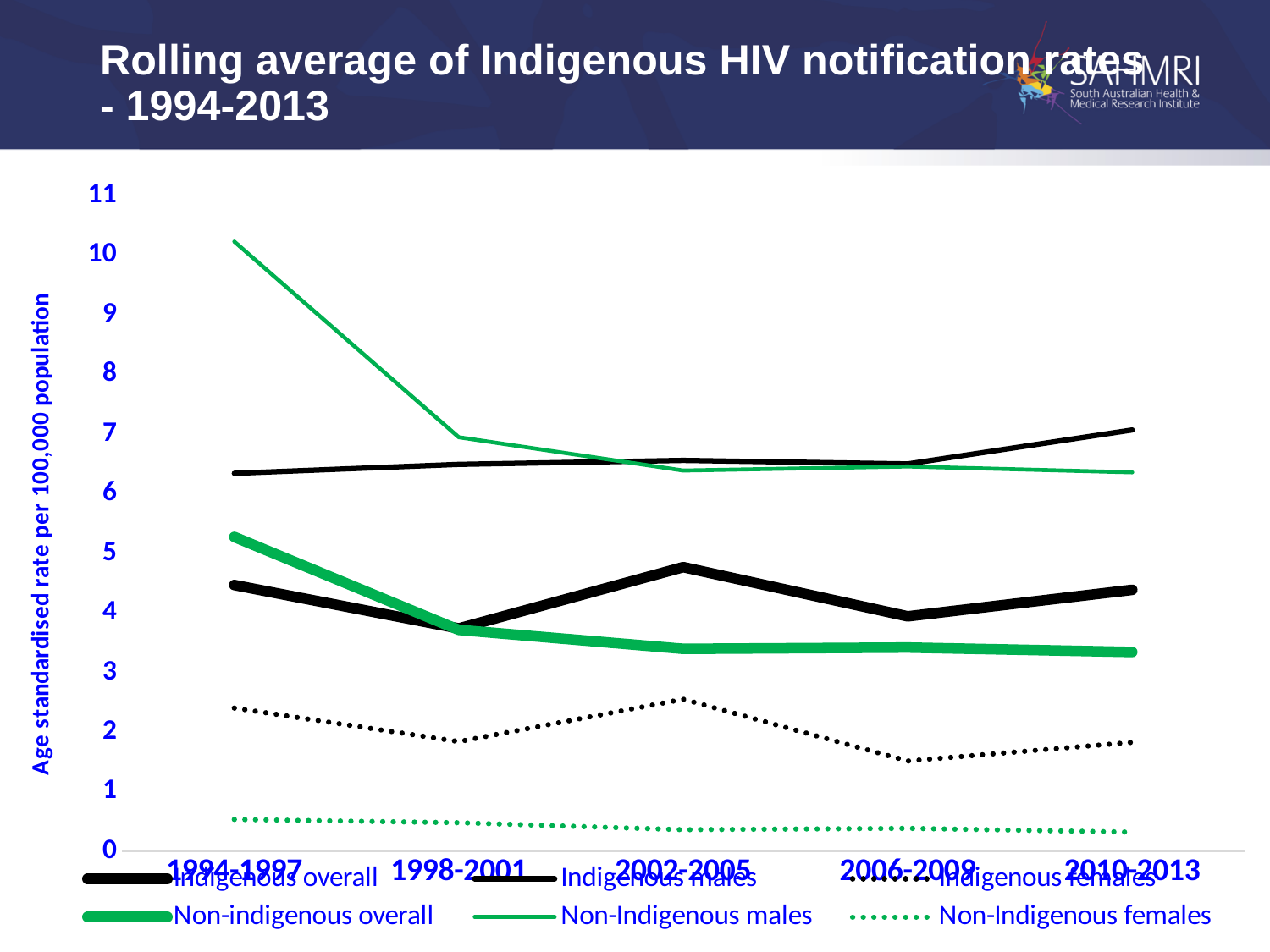
What kind of chart is shown on the slide? Line chart What is the label of the y axis? Age standardised rate per 100,000 population Is the value for Non-indigenous overall in 2010-2013 greater or less than 4? less Is the value for Indigenous males in 2010-2013 greater or less than 6? greater Does the Non-Indigenous males series rise or fall from 1994-1997 to 2010-2013? Fall In 2010-2013, which is larger: Indigenous overall or Non-indigenous overall? Indigenous overall Is the value for Indigenous females in 2006-2009 greater or less than 2? less How many time periods are shown along the x axis? 5 Which series has the lowest values across all periods? Non-Indigenous females Which series has the highest value in the 1994-1997 period? Non-Indigenous males How many series does the legend list? 6